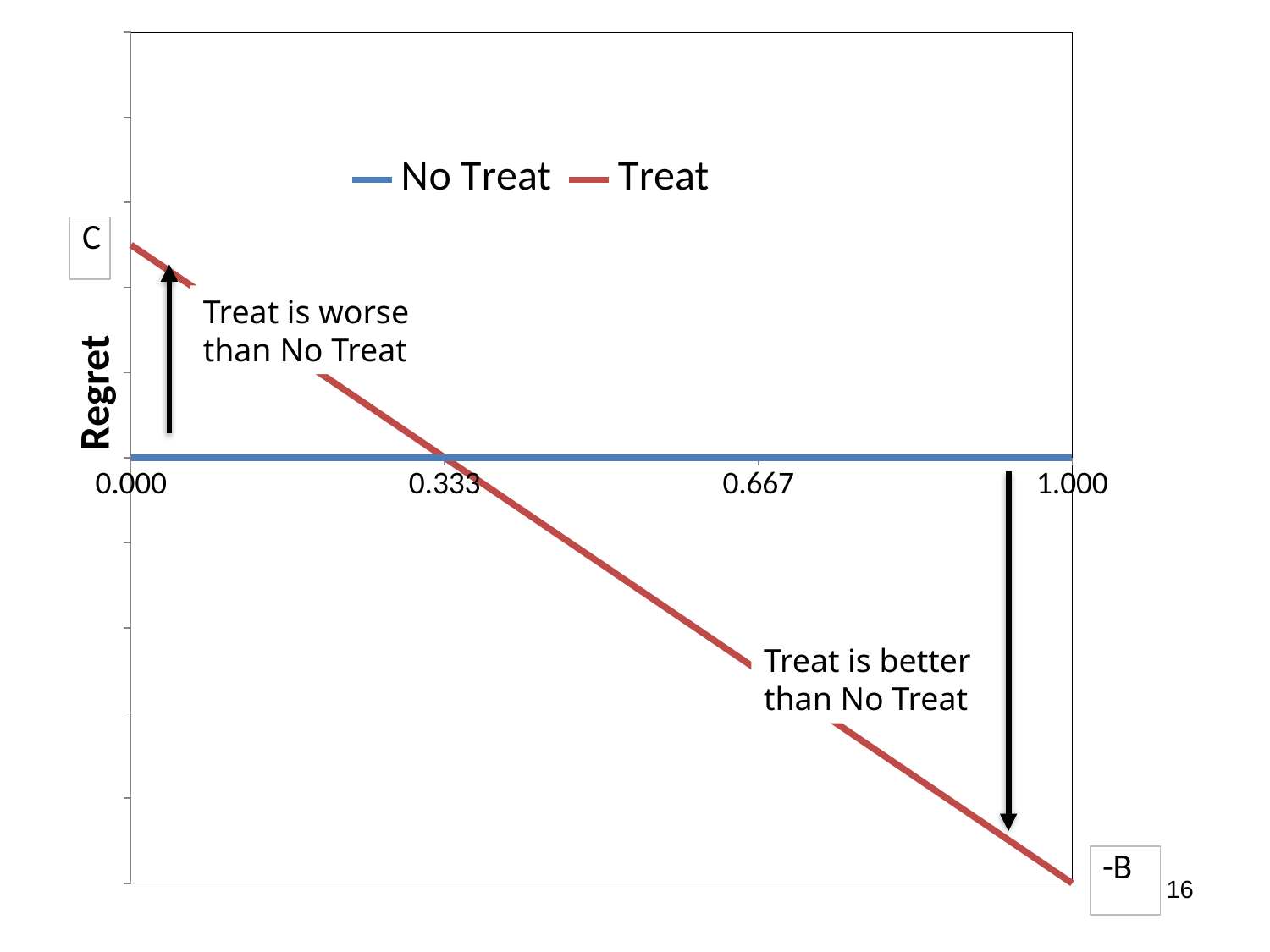
What kind of chart is shown on the slide? line chart What label marks the value of the Treat line at x = 0.000? C What label marks the value of the Treat line at x = 1.000? -B Which series are listed in the legend? No Treat and Treat How many series does the legend list? 2 At x = 1.000, which series has the higher Regret value, Treat or No Treat? No Treat How many tick labels are shown on the x axis? 4 At x = 0.000, which series has the higher Regret value, Treat or No Treat? Treat What is the title of the vertical axis? Regret Does the No Treat line rise, fall, or stay flat across the x axis? stay flat Does the Treat line rise or fall as the x-axis value increases from 0.000 to 1.000? fall At which labelled x-axis tick do the Treat and No Treat lines cross? 0.333